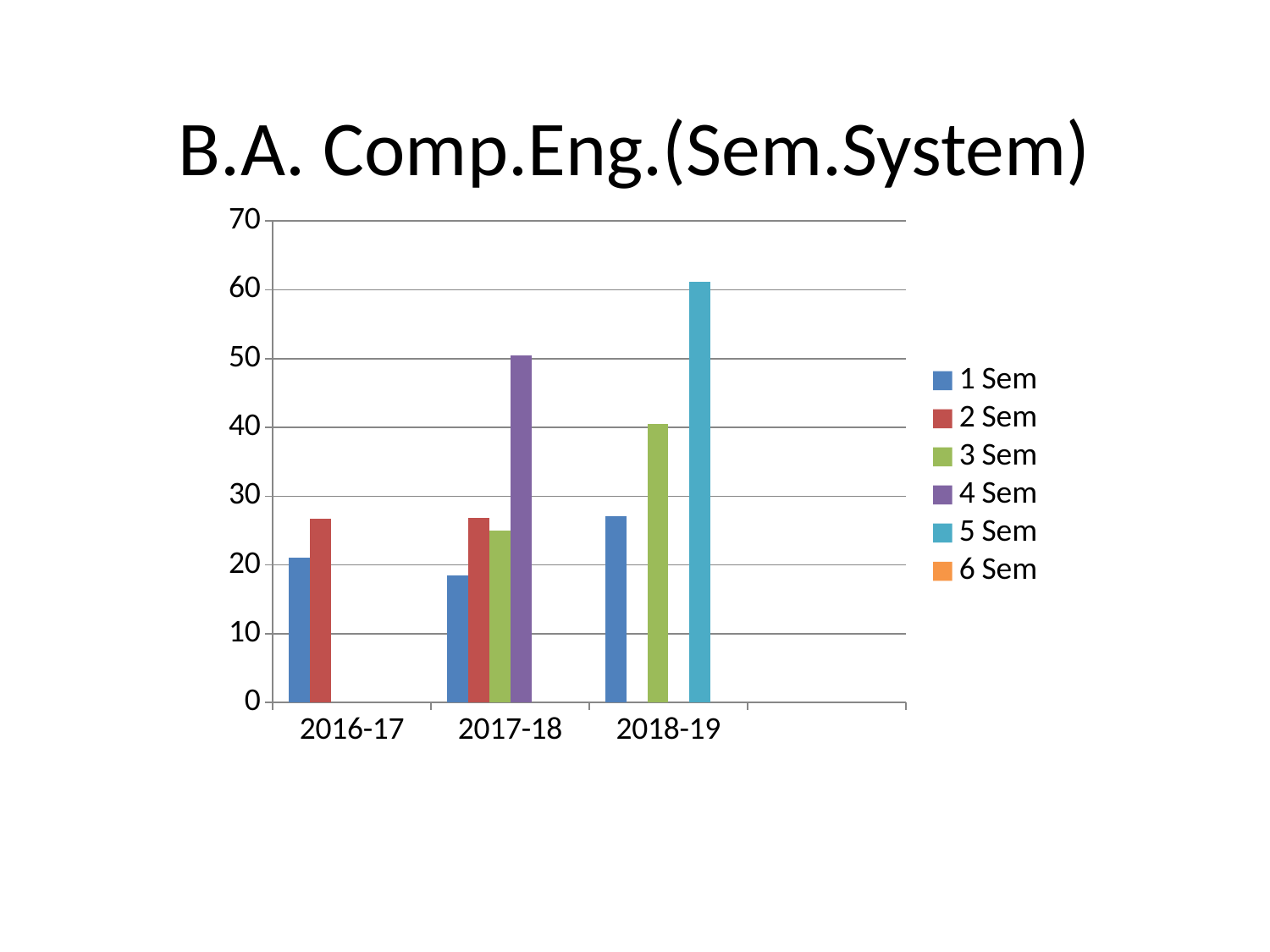
Which series has the tallest bar in the whole chart? 5 Sem Which is larger: 4 Sem in 2017-18 or 3 Sem in 2018-19? 4 Sem in 2017-18 What kind of chart is shown on the slide? bar chart In 2017-18, which series has the highest value? 4 Sem Is the value for 5 Sem in 2018-19 greater or less than 50? greater How many academic years are shown on the x axis? 3 In 2017-18, which series has the lowest value? 1 Sem Is the value for 1 Sem in 2017-18 greater or less than 20? less In 2016-17, which is larger: 1 Sem or 2 Sem? 2 Sem How many series does the legend list? 6 What is the title of the chart? B.A. Comp.Eng.(Sem.System) Which legend series has no visible bars in the chart? 6 Sem